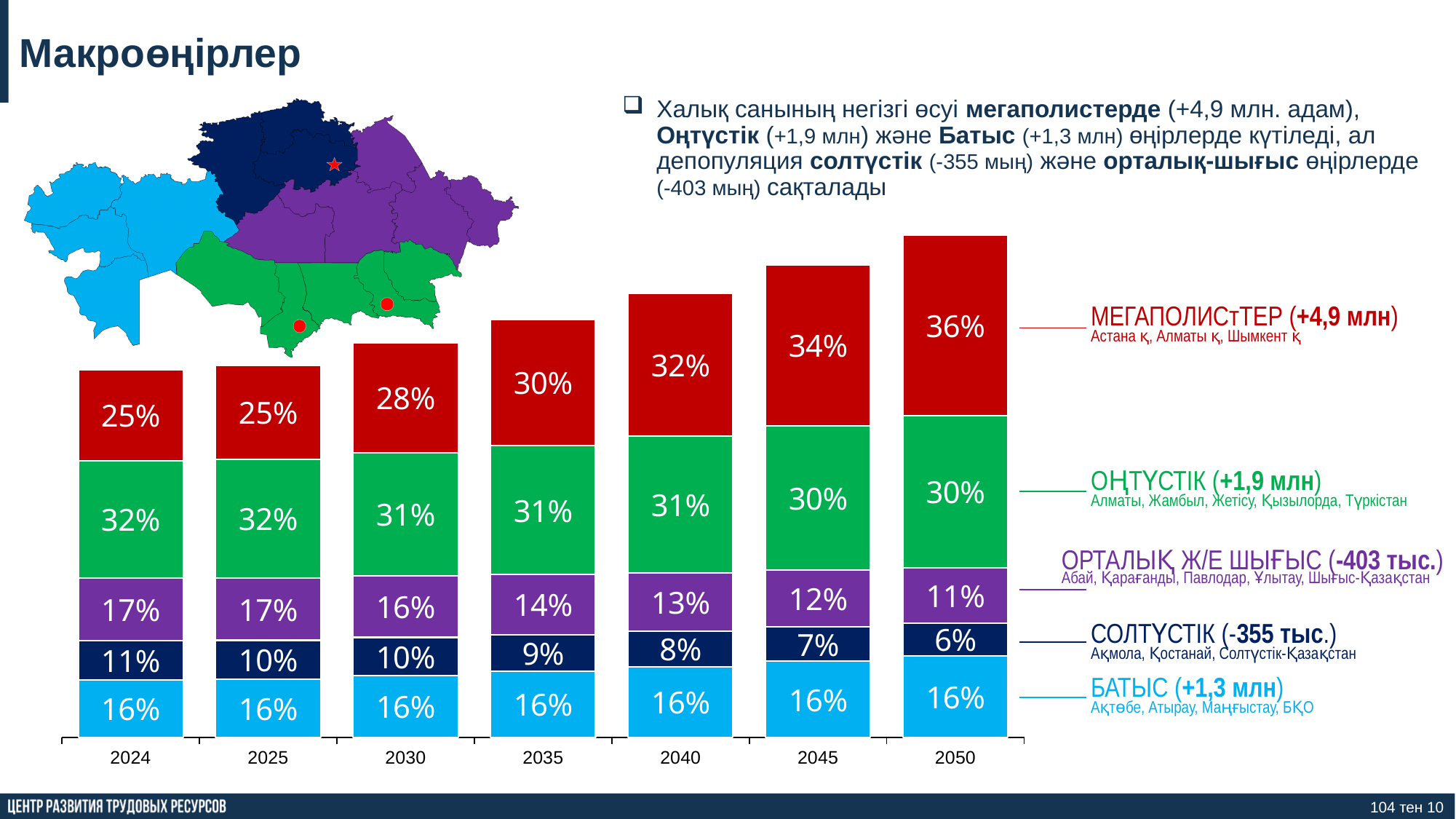
What is the share of МЕГАПОЛИСТЕР in 2050? 36% How many series (macro-regions) does the chart show? 5 What is the share of ОҢТҮСТІК in 2030? 31% What is the difference between the МЕГАПОЛИСТЕР share in 2050 and in 2024? 11 percentage points What is the share of ОРТАЛЫҚ Ж/Е ШЫҒЫС in 2040? 13% What type of chart is shown on the slide? stacked bar chart Which is larger in 2035: the share of ОҢТҮСТІК or the share of МЕГАПОЛИСТЕР? ОҢТҮСТІК How many years are shown on the x axis? 7 Does the share of ОРТАЛЫҚ Ж/Е ШЫҒЫС rise or fall from 2024 to 2050? fall What is the share of СОЛТҮСТІК in 2024? 11% In which year is the share of МЕГАПОЛИСТЕР highest? 2050 In which year is the share of СОЛТҮСТІК lowest? 2050